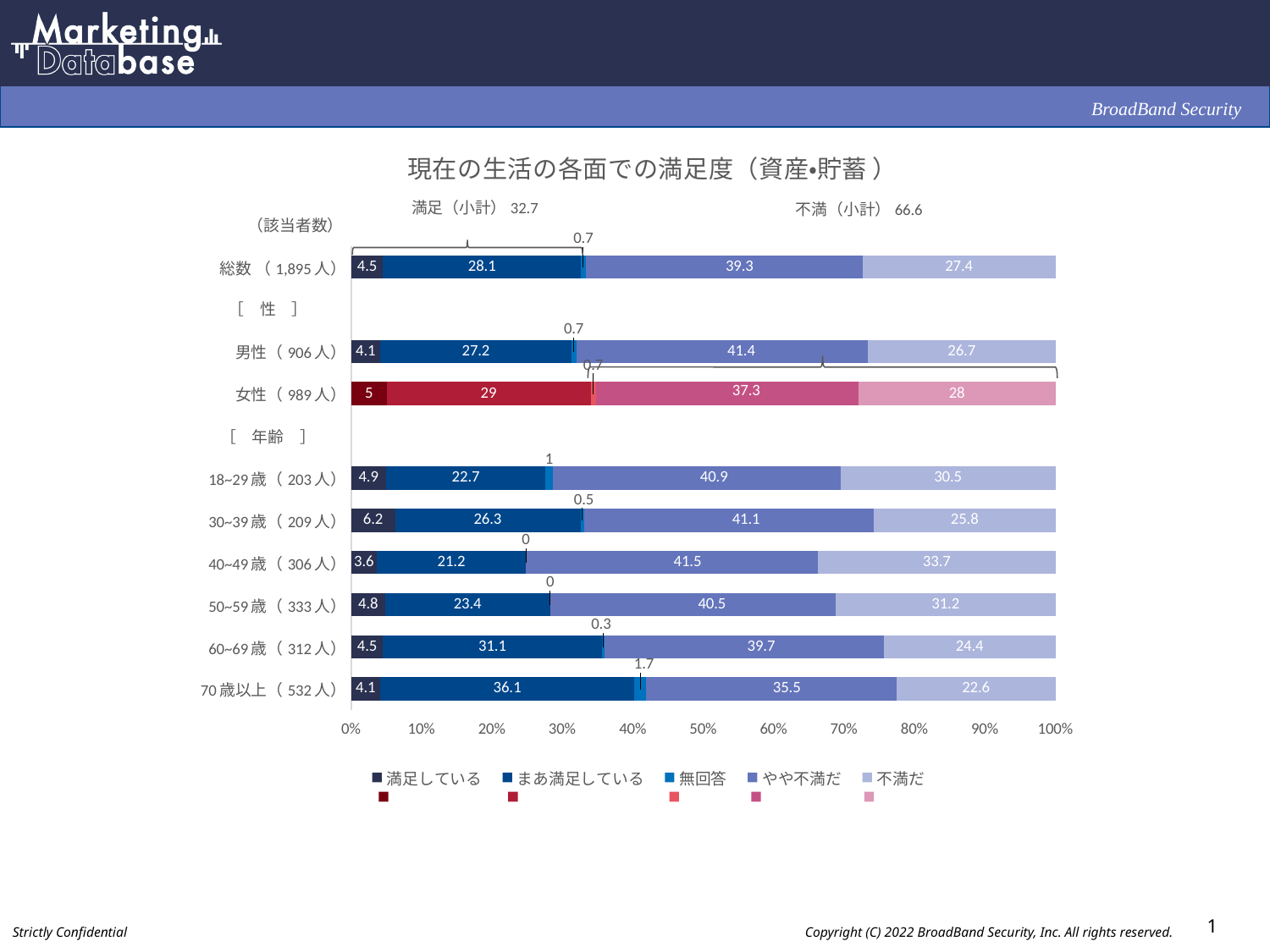
How many categories (bars) are plotted in the chart? 9 What is the 満足（小計） value shown above the chart? 32.7 Which category has the lowest value for 不満だ? 70歳以上 What is the value of 無回答 for 18~29歳? 1 Which is larger, the まあ満足している value for 女性 or for 男性? 女性 What is the value of まあ満足している for 70歳以上? 36.1 Which category has the highest value for 満足している? 30~39歳 What is the value of 不満だ for 総数? 27.4 What is the value of やや不満だ for 男性? 41.4 What kind of chart is shown on the slide? Stacked bar chart What is the difference between the 不満だ values for 40~49歳 and 60~69歳? 9.3 How many series does the legend list? 5